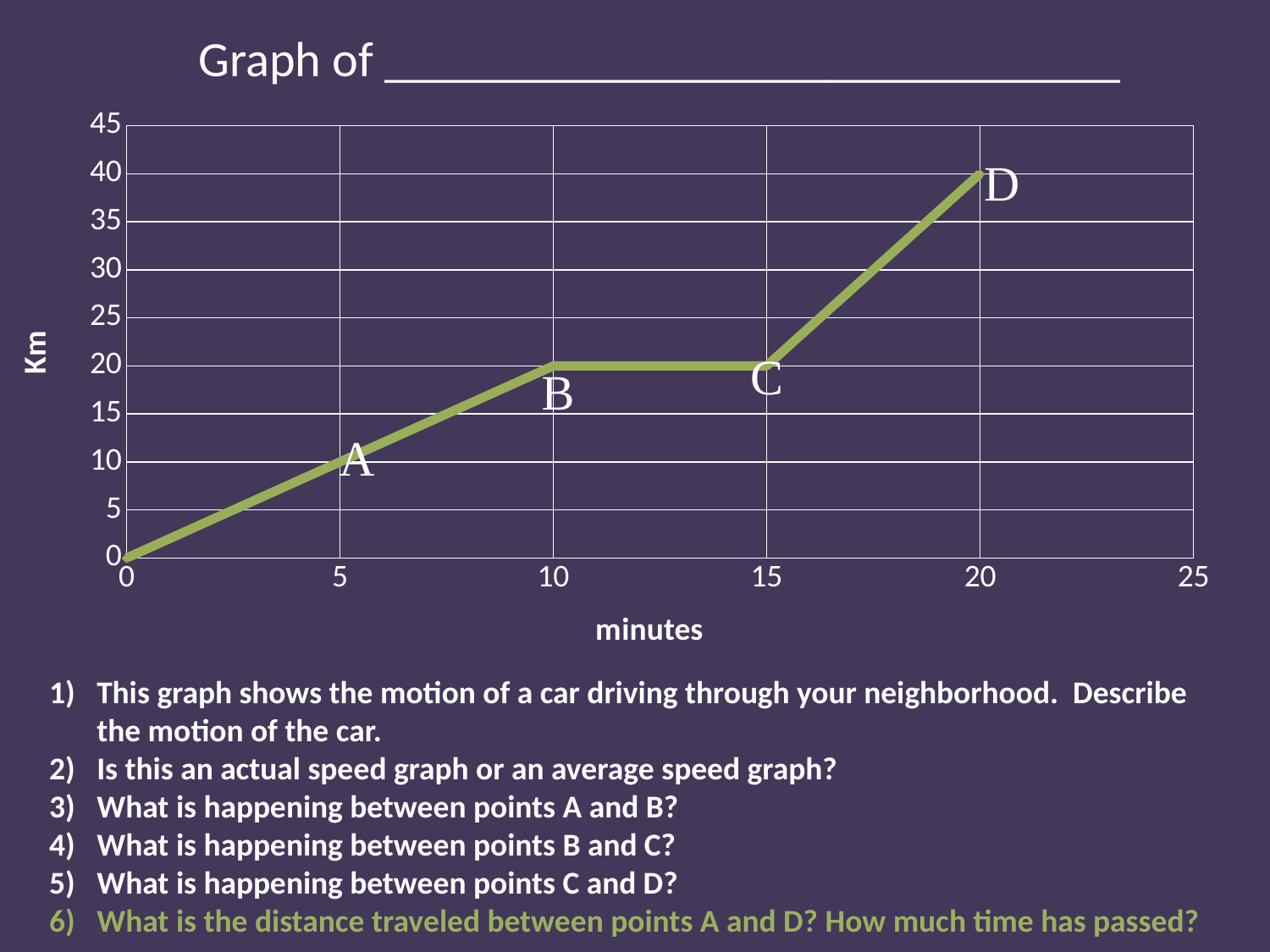
What kind of chart is shown on the slide? line chart What is the distance in km at point A? 10 At how many minutes does point B occur? 10 What is the label of the y axis? Km What is the difference in km between point D and point A? 30 Does the distance change between point B and point C? No, it stays at 20 What is the label of the x axis? minutes What is the distance in km at point C? 20 Which labeled point has the lowest distance value? A Which labeled point has the highest distance value? D How many labeled points are marked on the line? 4 What is the distance in km at point D? 40